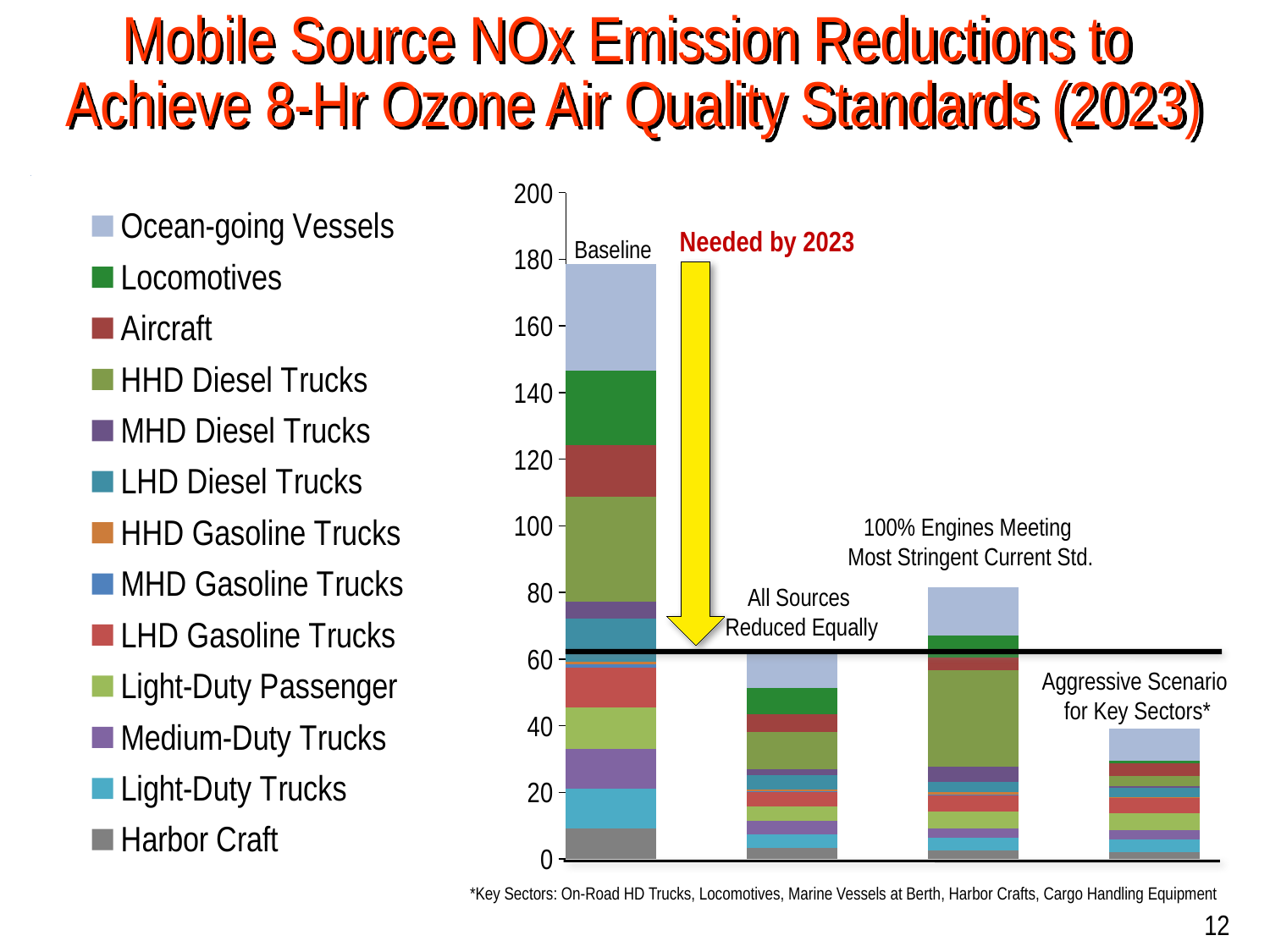
Which scenario has the tallest bar? Baseline Is the total for the All Sources Reduced Equally bar greater or less than 80? less Is the total for the Aggressive Scenario for Key Sectors* bar greater or less than 60? less Is the total for the 100% Engines Meeting Most Stringent Current Std. bar greater or less than 60? greater What label is written next to the yellow arrow in the chart? Needed by 2023 How many series does the legend list? 13 Which scenario has the shortest bar? Aggressive Scenario for Key Sectors* How many bars (scenarios) are plotted in the chart? 4 Which bar is taller: 100% Engines Meeting Most Stringent Current Std. or All Sources Reduced Equally? 100% Engines Meeting Most Stringent Current Std. Which series is listed first (at the top) in the legend? Ocean-going Vessels What kind of chart is shown on the slide? Stacked bar chart